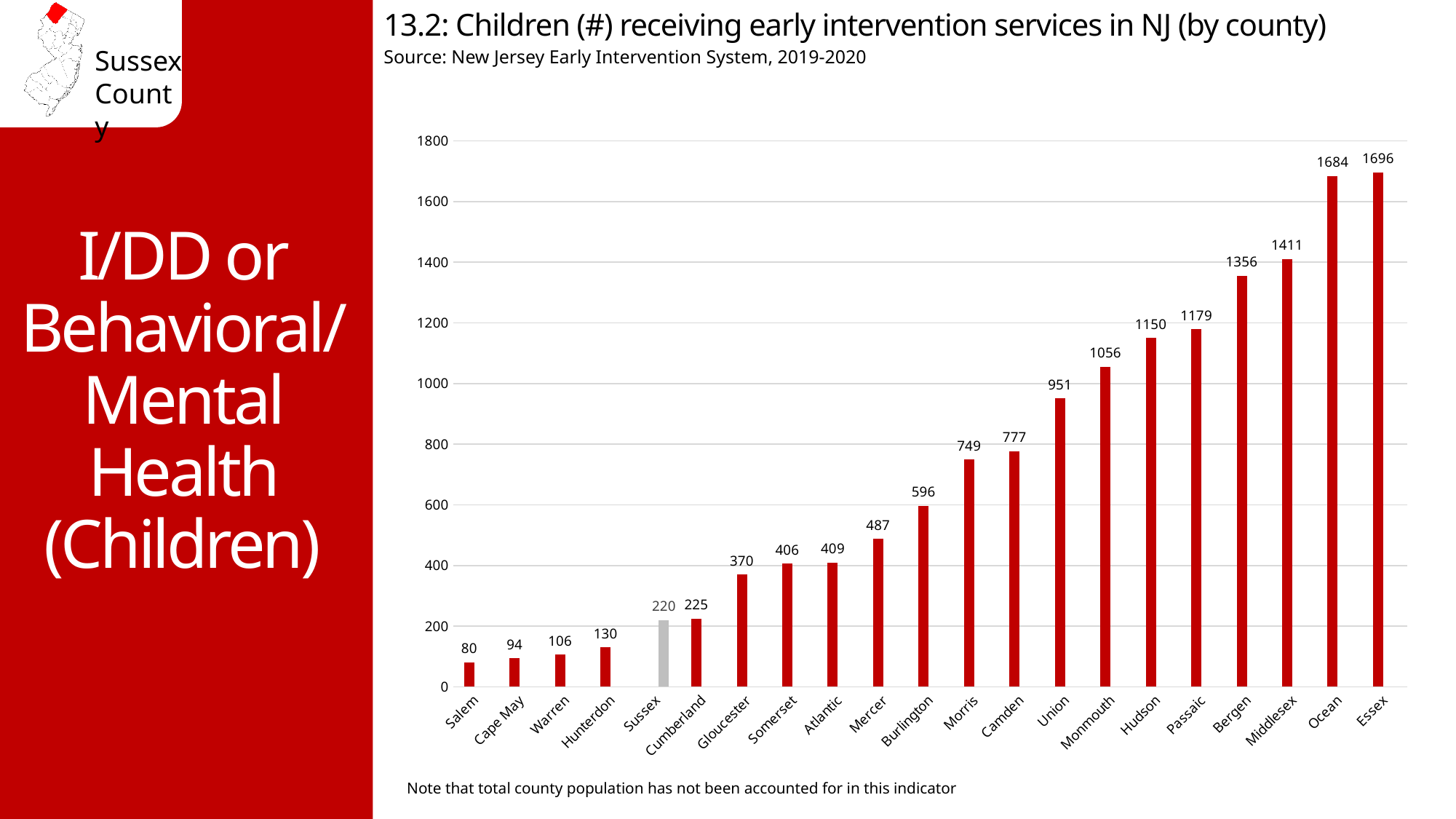
What is the value shown for Mercer? 487 How many counties are shown on the chart? 21 Which has a larger value, Passaic or Hudson? Passaic How many children received early intervention services in Sussex County? 220 What is the value shown for Monmouth? 1056 Which county has the lowest number of children receiving early intervention services? Salem Which county has the highest number of children receiving early intervention services? Essex Which county's bar is shown in gray rather than red? Sussex What is the difference between the values for Cumberland and Sussex? 5 What type of chart is shown on the slide? Bar chart Is the value for Union greater or less than 1000? less What is the difference between the values for Essex and Ocean? 12